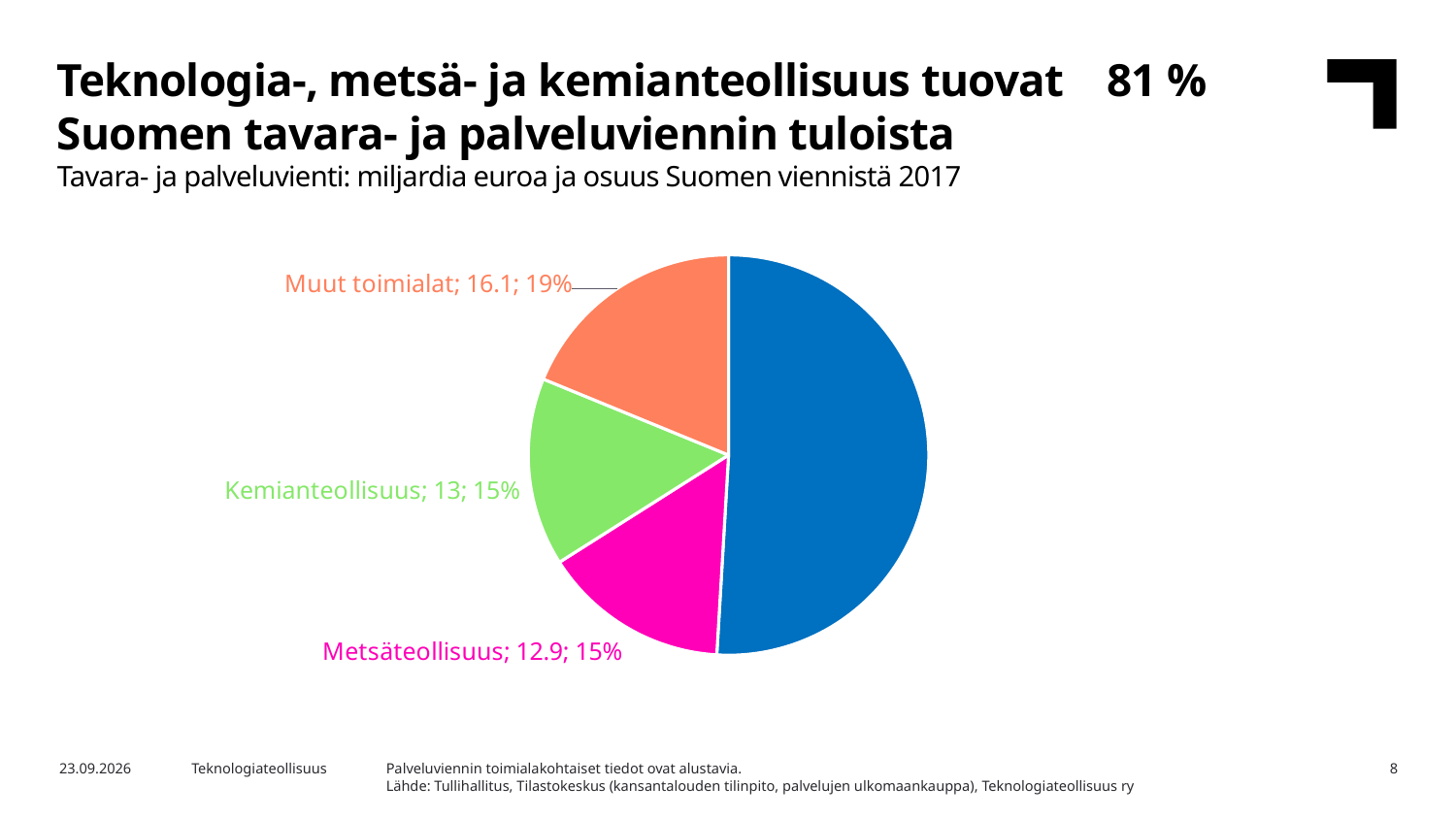
What share of the pie does Metsäteollisuus represent? 15% What is the value (in billion euros) shown for Metsäteollisuus? 12.9 What is the difference between the values for Muut toimialat and Kemianteollisuus? 3.1 How many slices does the pie chart have? 4 Which is larger, the value for Muut toimialat or the value for Kemianteollisuus? Muut toimialat What is the difference between the values for Muut toimialat and Metsäteollisuus? 3.2 What is the value (in billion euros) shown for Muut toimialat? 16.1 What kind of chart is shown on the slide? pie chart What share of the pie does Kemianteollisuus represent? 15% What is the value (in billion euros) shown for Kemianteollisuus? 13 What colour is the Metsäteollisuus slice of the pie chart? magenta (pink) What share of the pie does Muut toimialat represent? 19%